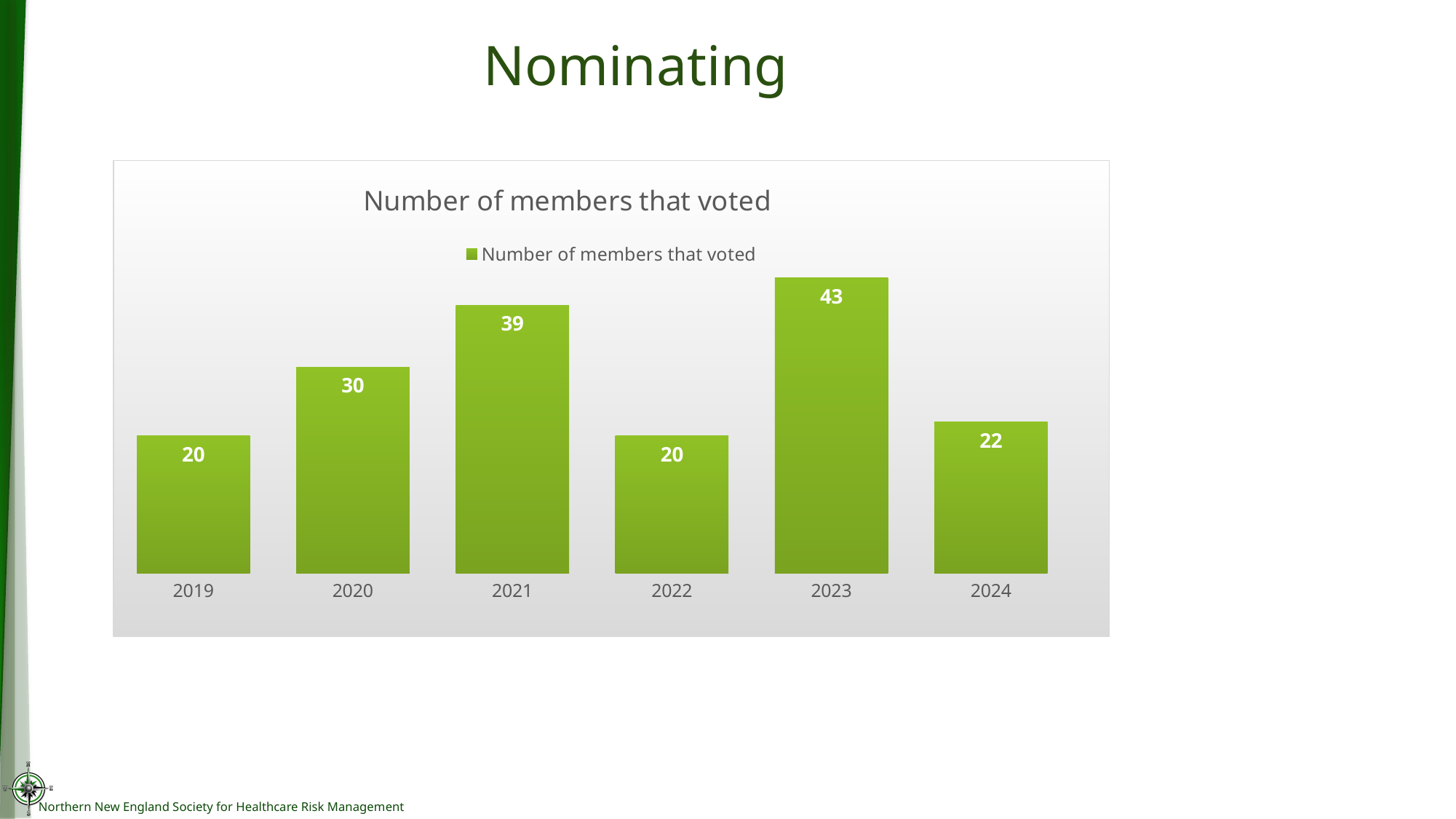
What kind of chart is shown on the slide? Bar chart What is the title of the chart? Number of members that voted How many series does the chart legend list? 1 Which year had the highest number of members that voted? 2023 What is the difference between the number of members that voted in 2023 and in 2022? 23 How many more members voted in 2020 than in 2019? 10 Which year had more members vote, 2021 or 2024? 2021 How many members voted in 2021? 39 How many years are shown on the x axis of the chart? 6 Did the number of members that voted rise or fall from 2023 to 2024? Fall What is the number of members that voted in 2024? 22 Which years had the lowest number of members that voted? 2019 and 2022